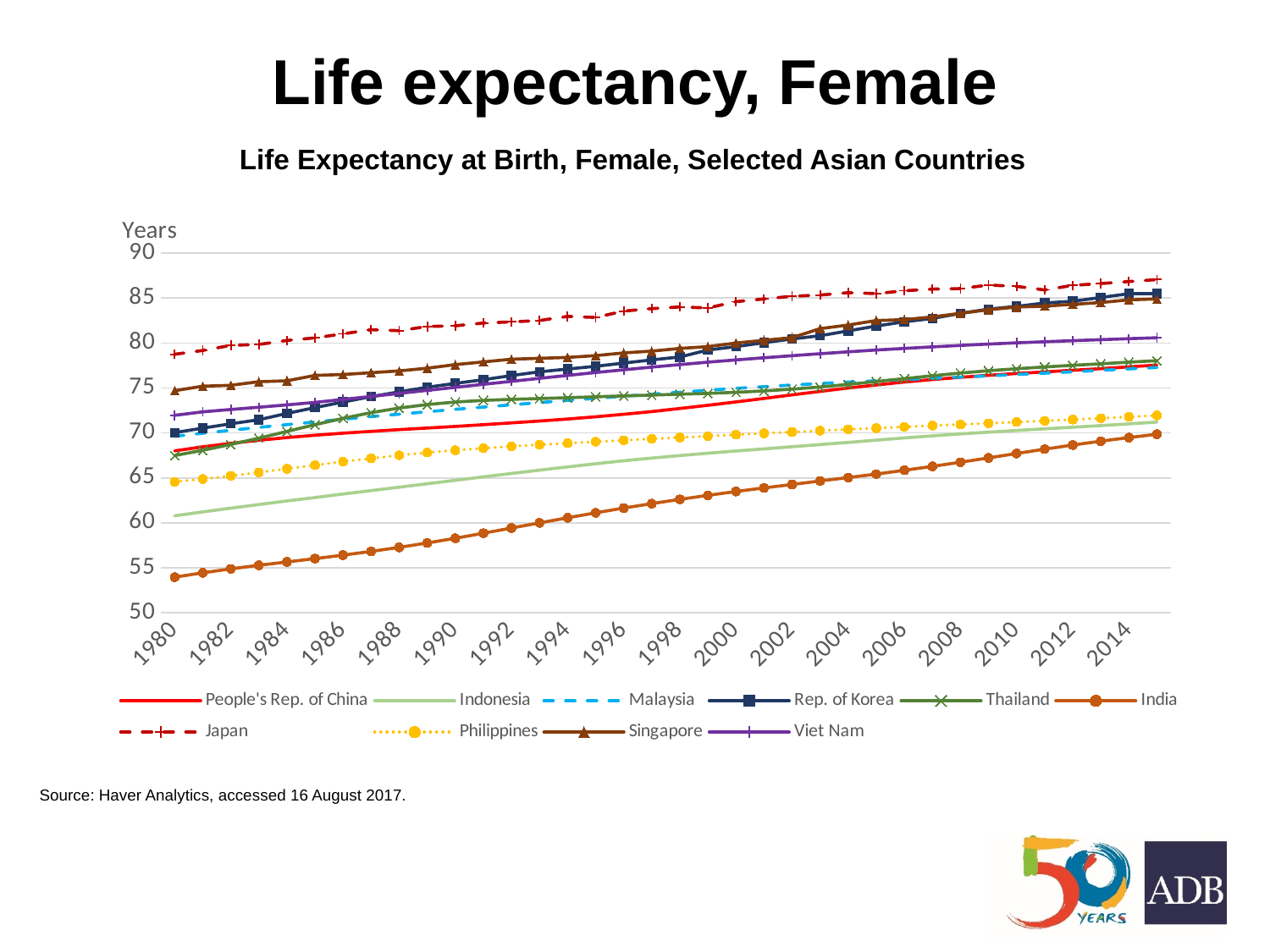
Which country has the highest female life expectancy throughout the period shown? Japan How many series does the legend list? 10 Is the value for Philippines in 2014 greater or less than 70? greater Is the value for People's Rep. of China in 1980 greater or less than 70? less In 2000, which has the higher female life expectancy, Japan or India? Japan Does female life expectancy for India rise or fall from 1980 to 2014? Rise What kind of chart is shown on the slide? Line chart Which country has the lowest female life expectancy throughout the period shown? India What unit is shown on the vertical axis of the chart? Years Is the value for India in 1980 greater or less than 55? less In 1990, which has the higher female life expectancy, Singapore or Indonesia? Singapore